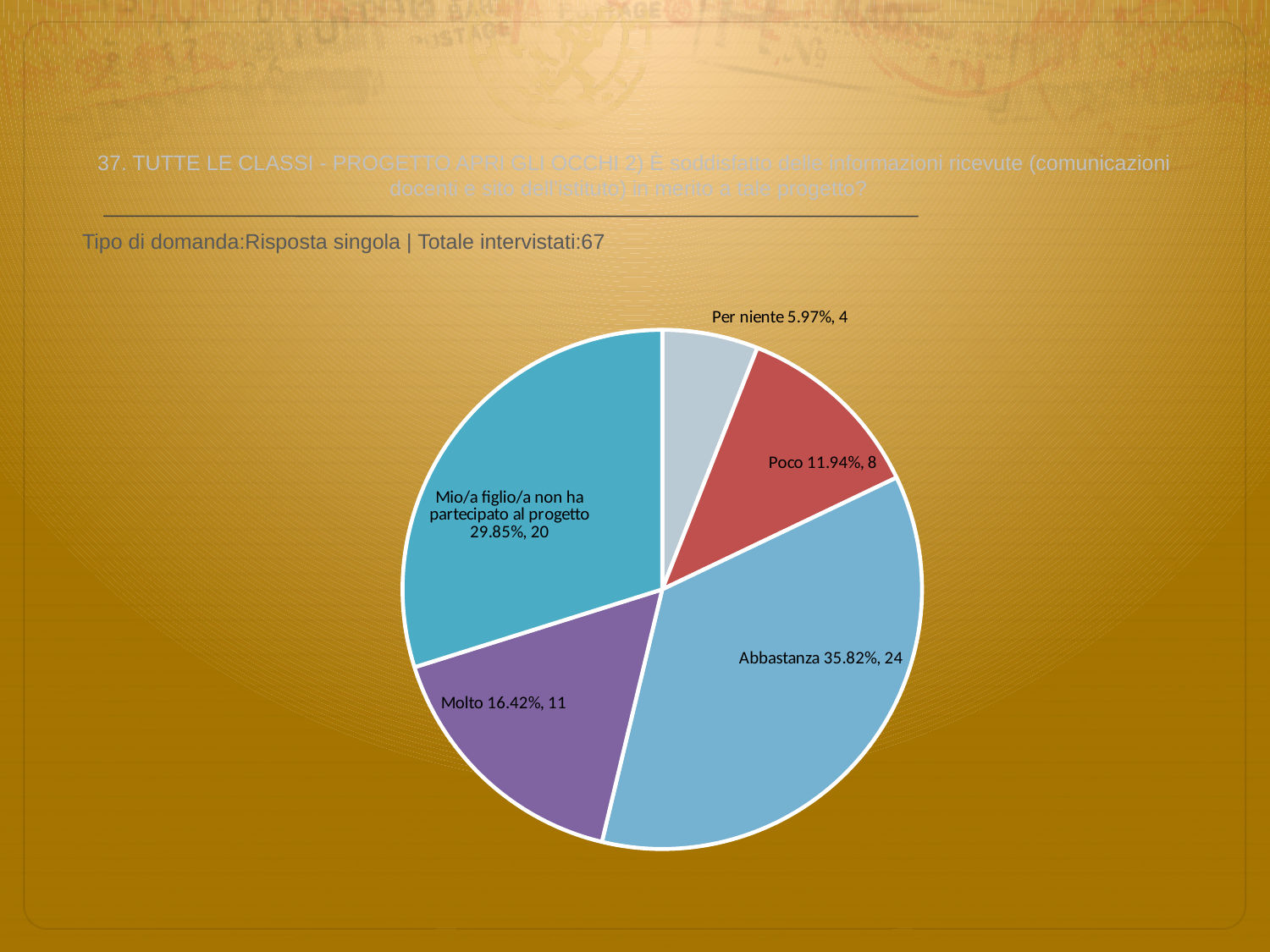
What kind of chart is shown on the slide? Pie chart What percentage is shown for 'Mio/a figlio/a non ha partecipato al progetto'? 29.85% What share of the pie does the 'Per niente' slice represent? 5.97% What is the difference in count between 'Abbastanza' and 'Molto'? 13 What is the count for the 'Molto' slice? 11 What is the count for the 'Abbastanza' slice? 24 Which slice is the smallest? Per niente What percentage is shown for the 'Poco' slice? 11.94% Which slice is the largest? Abbastanza Which has a larger count, 'Poco' or 'Per niente'? Poco How many slices does the pie chart have? 5 What is the total number of respondents shown on the slide? 67